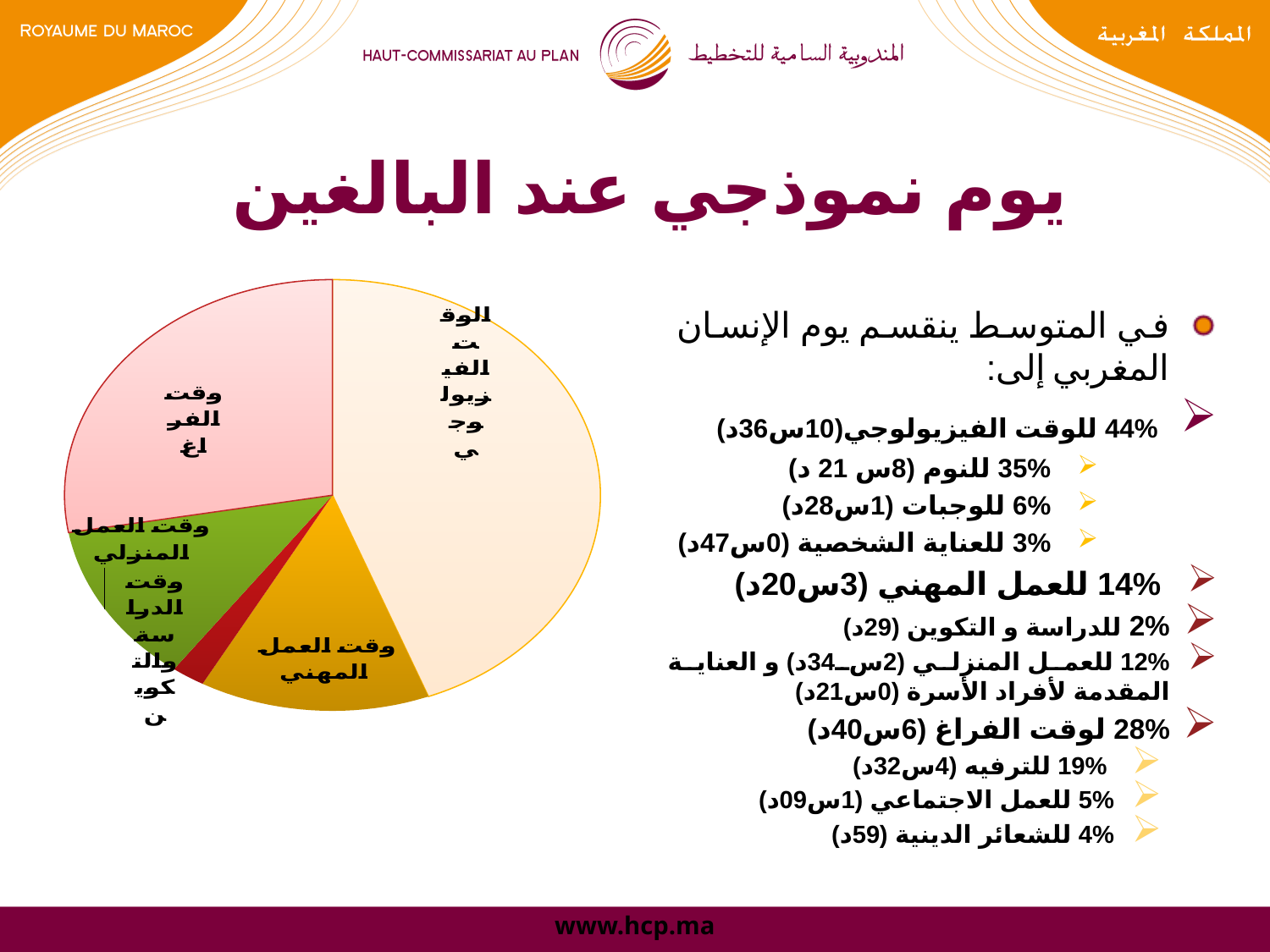
Which slice is larger in the pie chart: وقت الفراغ or وقت العمل المهني? وقت الفراغ Which slice of the pie chart is the largest? الوقت الفيزيولوجي Which slice is larger in the pie chart: وقت العمل المنزلي or وقت الدراسة والتكوين? وقت العمل المنزلي What is the title of the slide containing the pie chart? يوم نموذجي عند البالغين What kind of chart is shown on the slide? pie chart What colour is the وقت الفراغ slice in the pie chart? pink Which slice is larger in the pie chart: الوقت الفيزيولوجي or وقت الفراغ? الوقت الفيزيولوجي How many slices does the pie chart have? 5 Which slice of the pie chart is the smallest? وقت الدراسة والتكوين